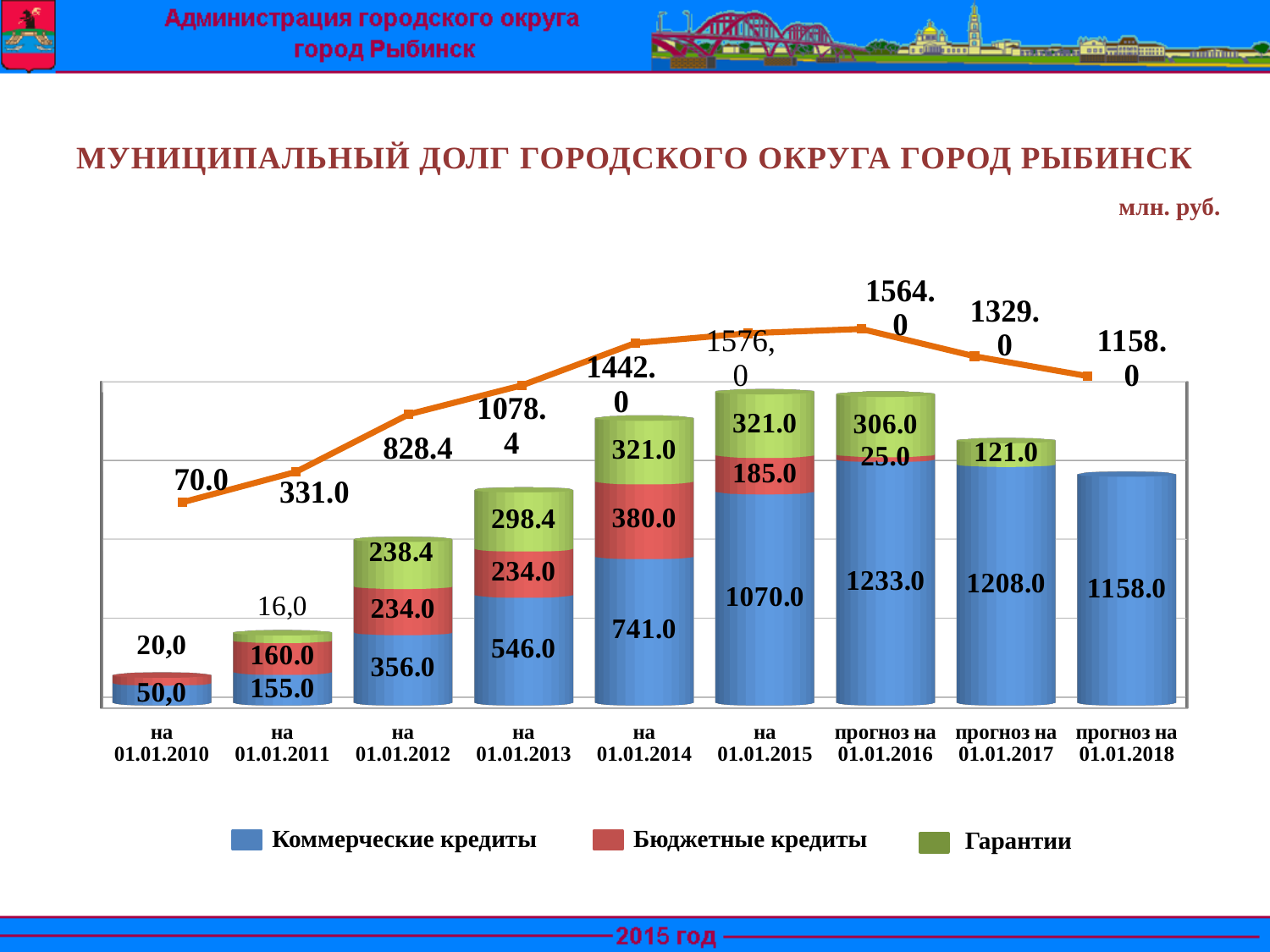
What is the total of the stacked bar for на 01.01.2012? 828.4 What is the value of Гарантии for прогноз на 01.01.2017? 121.0 What is the difference between Коммерческие кредиты for на 01.01.2015 and на 01.01.2014? 329.0 Which category has the highest value of Коммерческие кредиты? прогноз на 01.01.2016 How many categories are shown on the x axis? 9 Which is larger: Бюджетные кредиты for на 01.01.2014 or for на 01.01.2015? на 01.01.2014 What is the value of Бюджетные кредиты for на 01.01.2013? 234.0 Which category has the lowest value of Коммерческие кредиты? на 01.01.2010 What unit is stated for the values on the chart? млн. руб. What is the value of Коммерческие кредиты for на 01.01.2014? 741.0 What kind of chart is shown on the slide? stacked bar chart with a line How many series does the legend list? 3